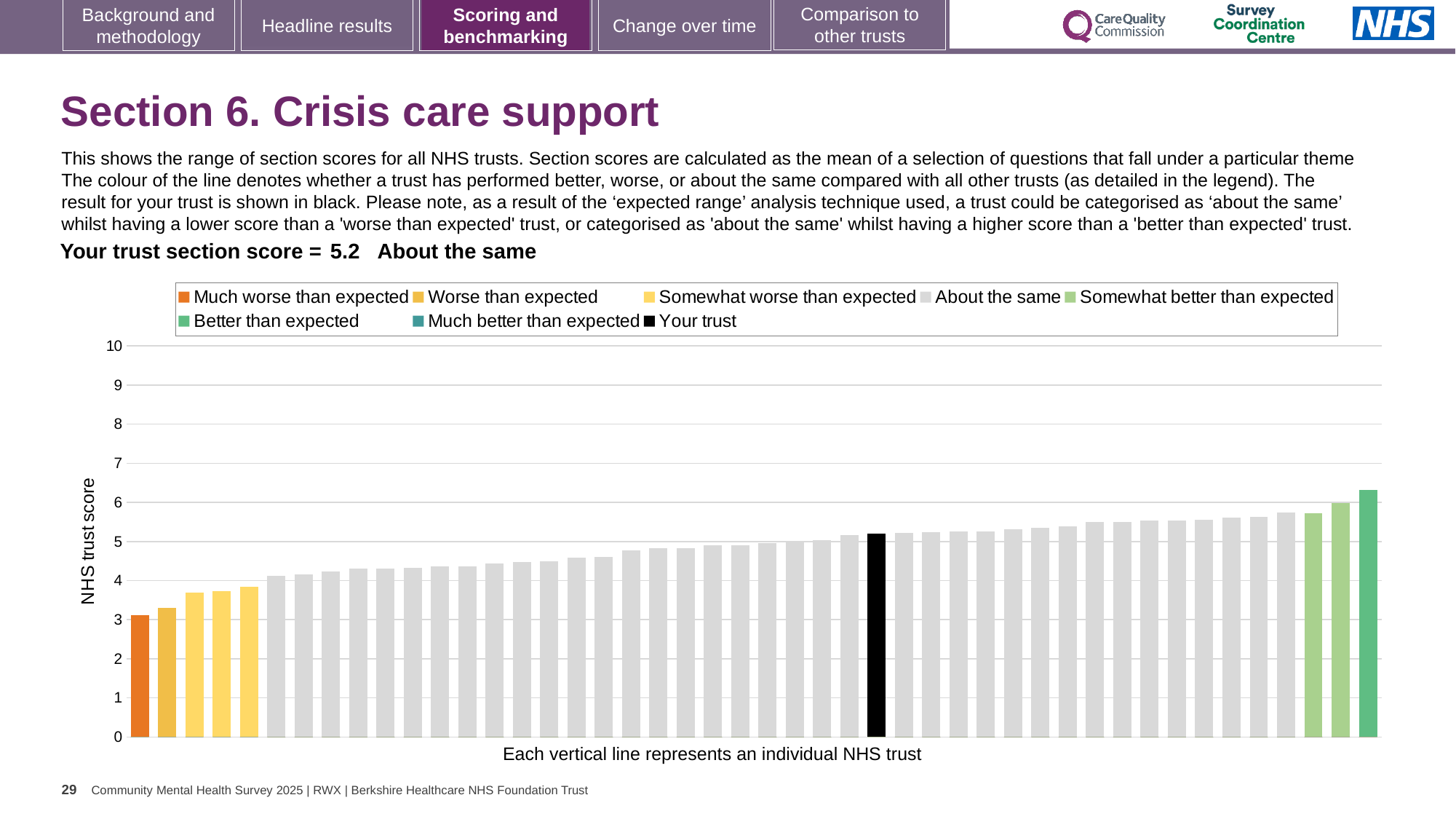
What colour is the bar representing your trust? black How many bars are coloured as 'Somewhat worse than expected'? 3 How many entries does the legend list? 8 Which legend category does the highest bar belong to? Better than expected What is the section score for your trust? 5.2 Is the value of the highest bar greater or less than 6? greater Is the value of the lowest bar greater or less than 4? less What kind of chart is shown on the slide? bar chart Is the value for your trust greater or less than 5? greater Which legend category does the lowest bar belong to? Much worse than expected Do the bar values rise or fall from left to right along the x axis? rise Which category is your trust's section score placed in? About the same